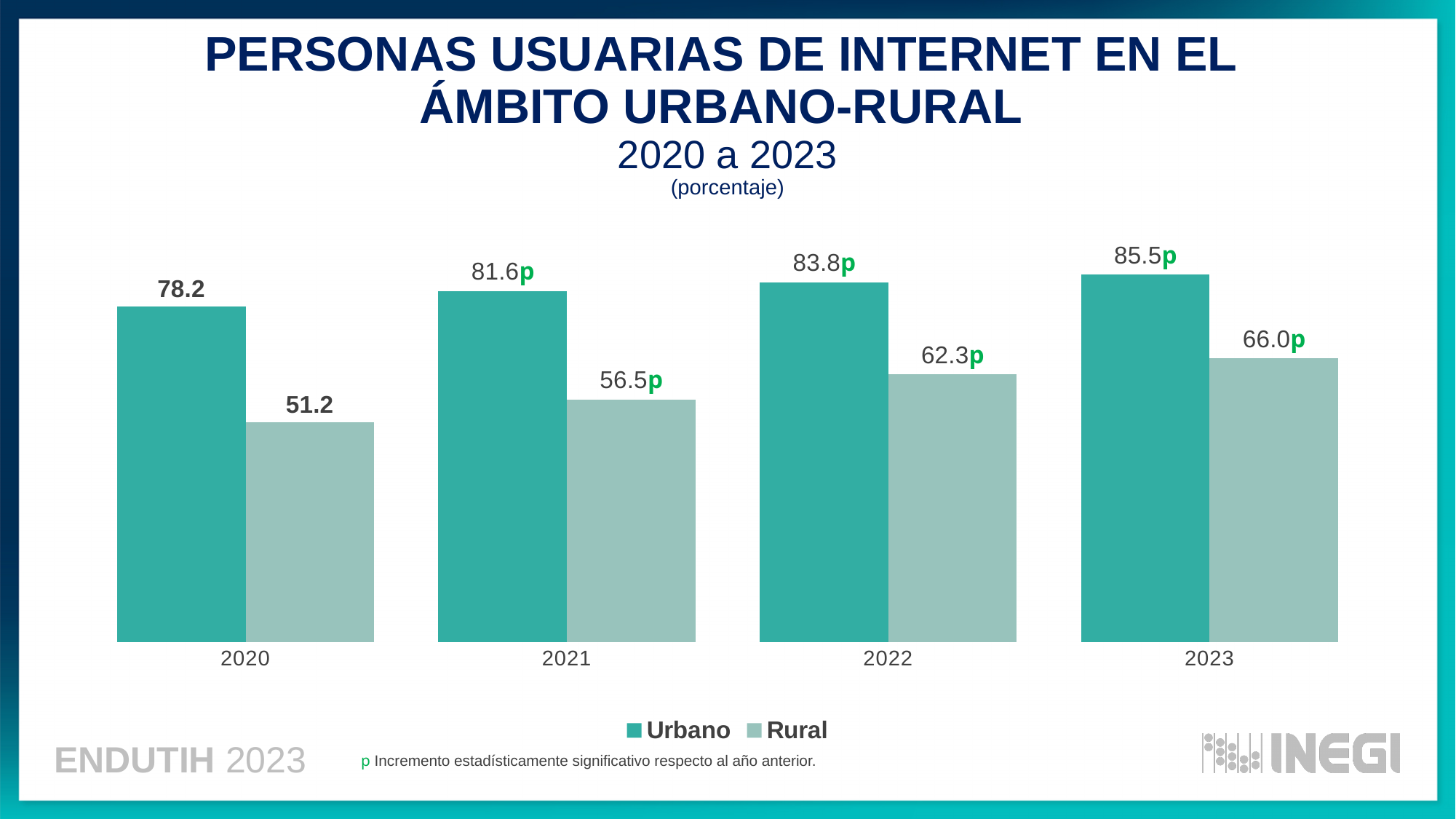
What is the difference between the Urbano and Rural values in 2022? 21.5 How many years are shown on the x axis? 4 What is the Rural value for 2021? 56.5 Which year has the highest Urbano value? 2023 What kind of chart is shown on the slide? Bar chart What is the Rural value for 2023? 66.0 What is the Urbano value for 2020? 78.2 By how much did the Rural value increase from 2020 to 2023? 14.8 Do the Rural values rise or fall from 2020 to 2023? Rise Which year has the lowest Rural value? 2020 How many series does the legend list? 2 Which is larger in 2021, the Urbano value or the Rural value? Urbano